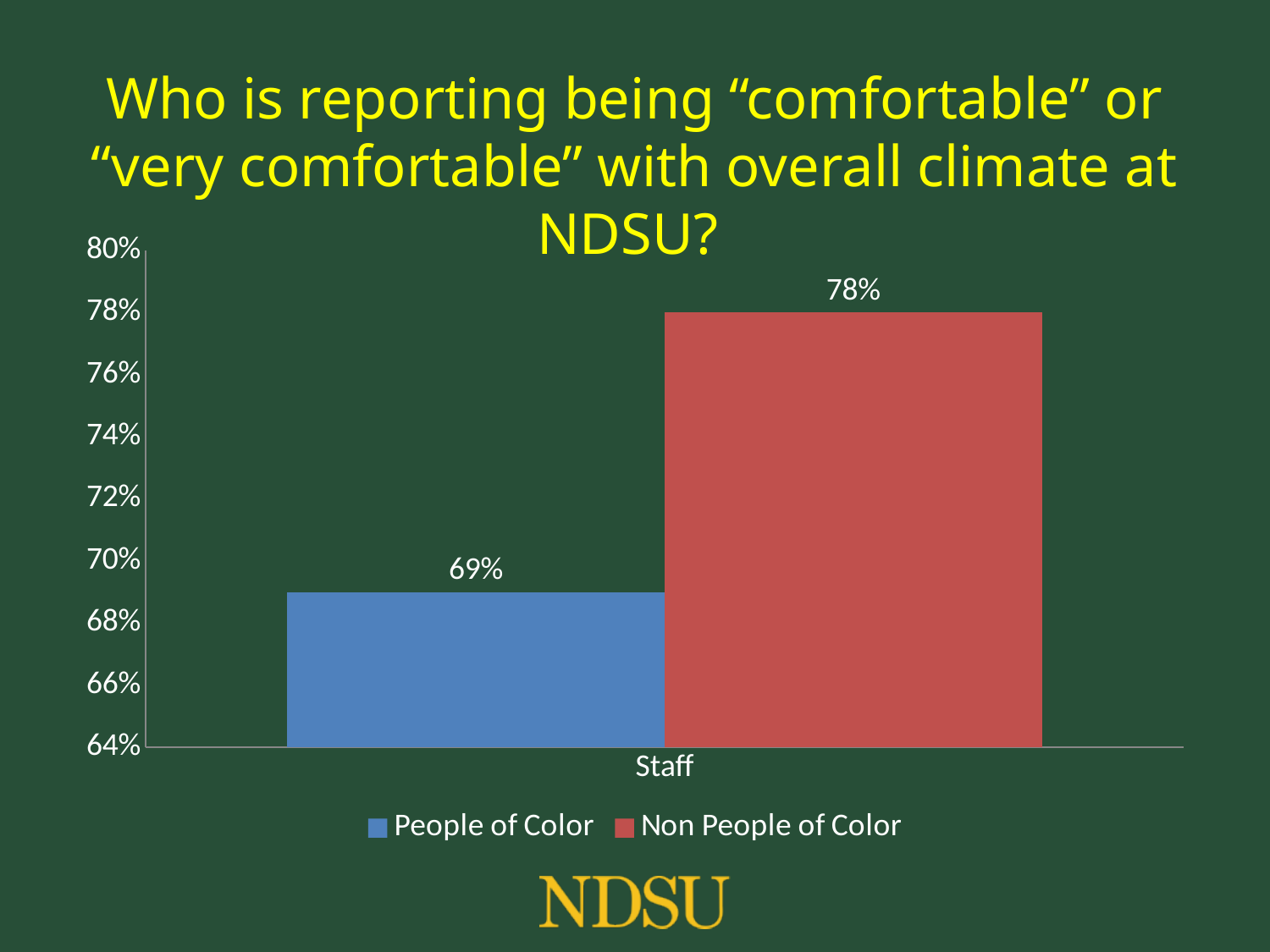
What kind of chart is shown on the slide? Bar chart What is the category label on the x axis? Staff How many categories are shown on the x axis? 1 What percentage of Staff who are Non People of Color report being comfortable or very comfortable with the overall climate at NDSU? 78% Is the value for Non People of Color greater or less than 76%? greater Is the value for People of Color greater or less than 70%? less How many series does the legend list? 2 Which series has the lowest value in the chart? People of Color What percentage of Staff who are People of Color report being comfortable or very comfortable with the overall climate at NDSU? 69% Which series has the higher value for Staff, People of Color or Non People of Color? Non People of Color What colour is the bar for Non People of Color? Red What is the difference in percentage points between Non People of Color and People of Color for Staff? 9 percentage points